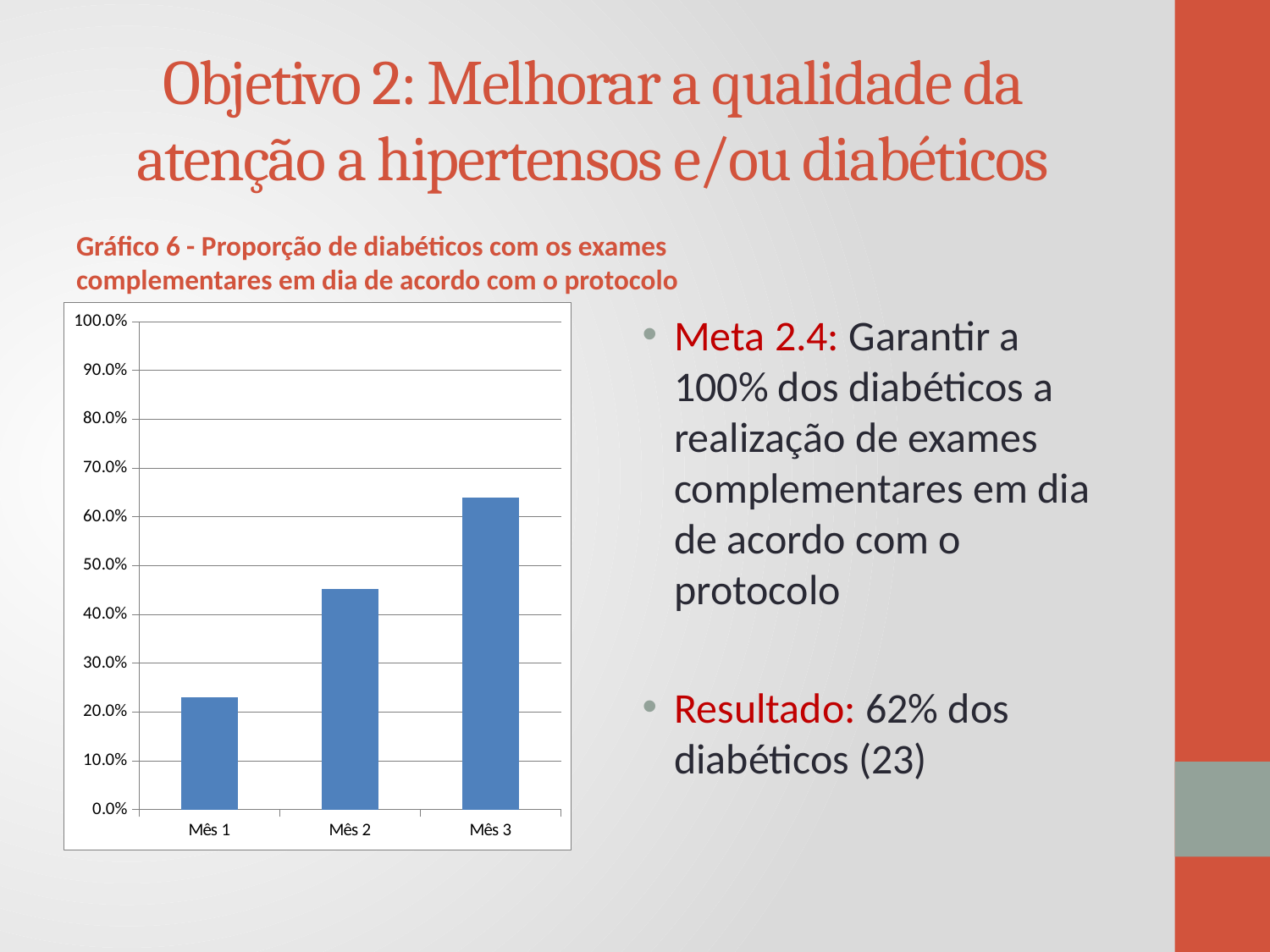
What is the maximum value shown on the chart's vertical axis? 100.0% Is the value for Mês 3 greater or less than 70.0%? less Which is larger, the value for Mês 1 or the value for Mês 2? Mês 2 Do the values rise or fall from Mês 1 to Mês 3? rise Which month has the highest proportion on the chart? Mês 3 Is the value for Mês 2 greater or less than 50.0%? less How many categories (months) are plotted on the chart? 3 Is the value for Mês 2 greater or less than 40.0%? greater Which month has the lowest proportion on the chart? Mês 1 What kind of chart is shown on the slide? bar chart